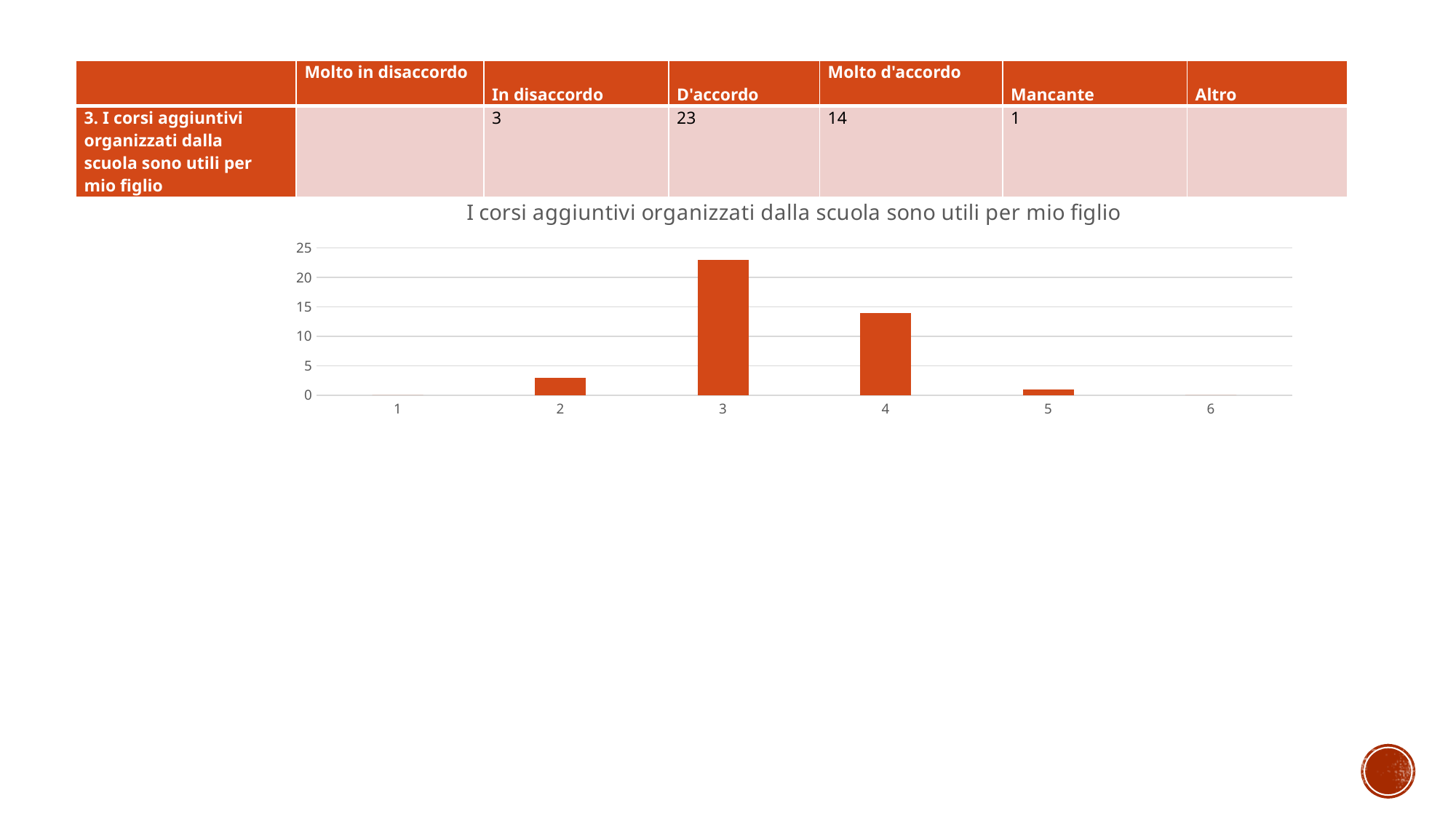
Which is larger, the value for category 2 or the value for category 4? category 4 According to the table, what is the value for Molto d'accordo (category 4)? 14 Is the value for category 4 greater or less than 15? less Which category has the highest bar in the chart? 3 According to the table, what is the value for Mancante (category 5)? 1 What kind of chart is shown on the slide? bar chart What is the title of the chart? I corsi aggiuntivi organizzati dalla scuola sono utili per mio figlio According to the table, what is the value for D'accordo (category 3)? 23 What is the difference between the values for category 3 and category 4? 9 How many categories are shown on the x axis of the chart? 6 Is the value for category 3 greater or less than 20? greater According to the table, what is the value for In disaccordo (category 2)? 3